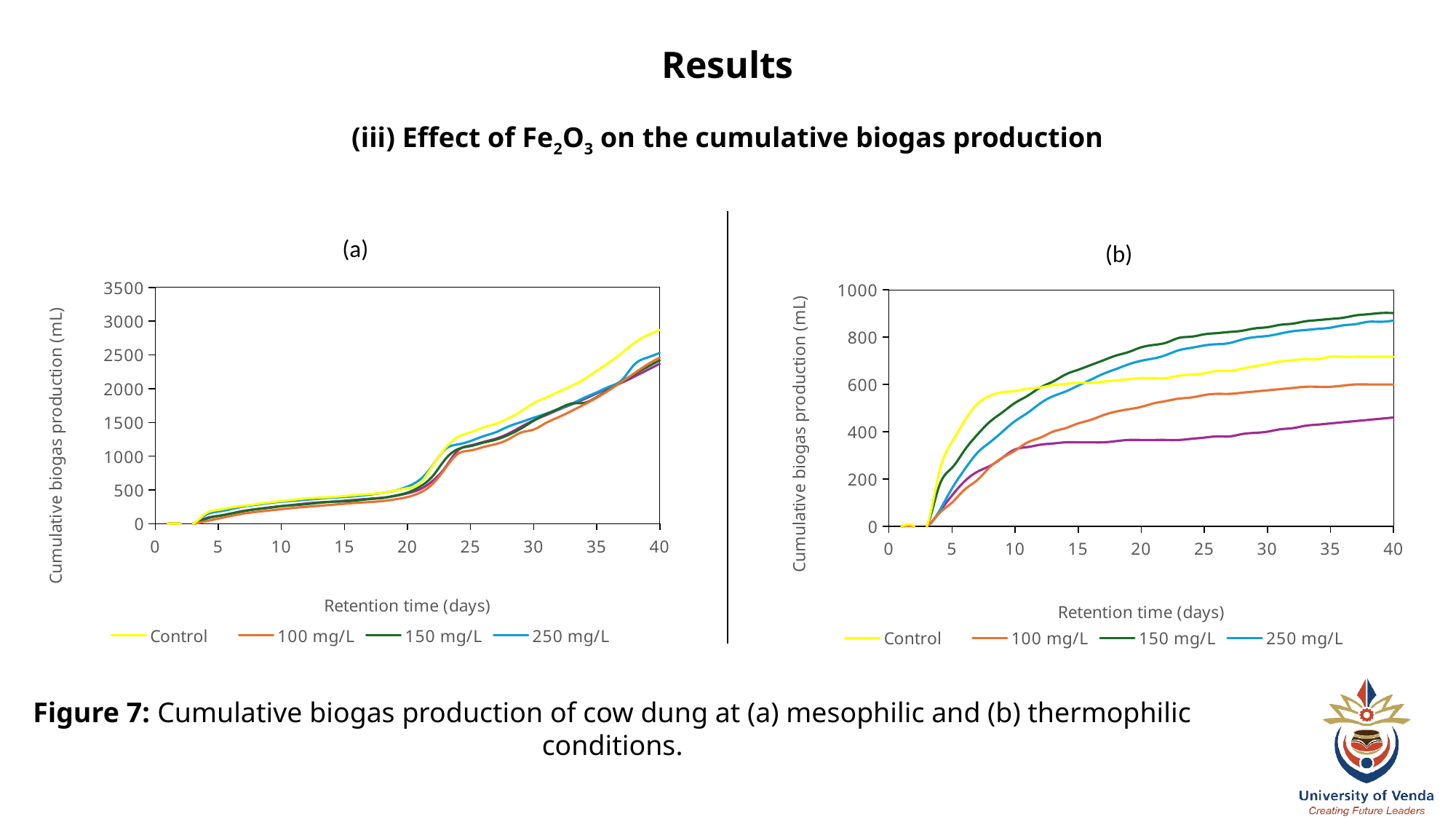
In chart (b), which series has the highest value at day 40? 150 mg/L How many series does the legend of chart (b) list? 4 In chart (b), which is larger at day 40, 150 mg/L or Control? 150 mg/L In chart (a), which series has the highest value at day 40? Control In chart (b), is the value for Control at day 40 greater or less than 600? greater In chart (b), is the value for 150 mg/L at day 40 greater or less than 800? greater What kind of chart is chart (a)? line chart What is the x-axis title of chart (b)? Retention time (days) In chart (a), do the values generally rise or fall as retention time increases? rise In chart (b), is the value for 100 mg/L at day 10 greater or less than 400? less In chart (b), which is larger at day 10, Control or 100 mg/L? Control